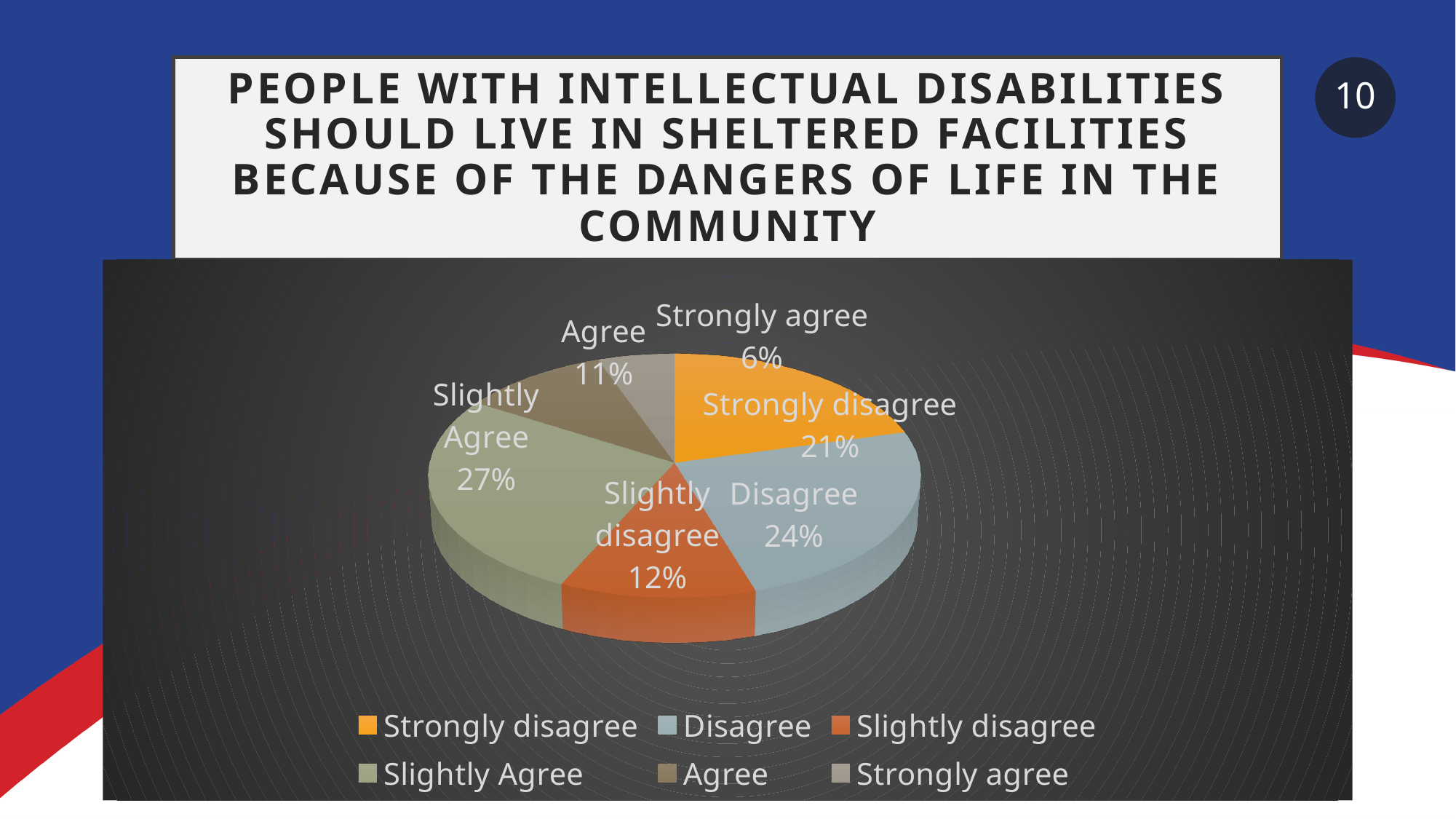
Which response category has the largest share of the pie? Slightly Agree What kind of chart is shown on the slide? Pie chart How many response categories are shown in the pie chart? 6 Which response category has the smallest share of the pie? Strongly agree What percentage of respondents chose Disagree? 24% What is the difference in percentage points between Disagree and Slightly disagree? 12 What percentage of respondents chose Strongly disagree? 21% Which colour represents Slightly disagree in the legend? Orange-red Which is larger, the share for Agree or the share for Strongly disagree? Strongly disagree What percentage of respondents chose Strongly agree? 6% What percentage of respondents chose Slightly Agree? 27% What is the combined percentage of Strongly disagree, Disagree and Slightly disagree? 57%